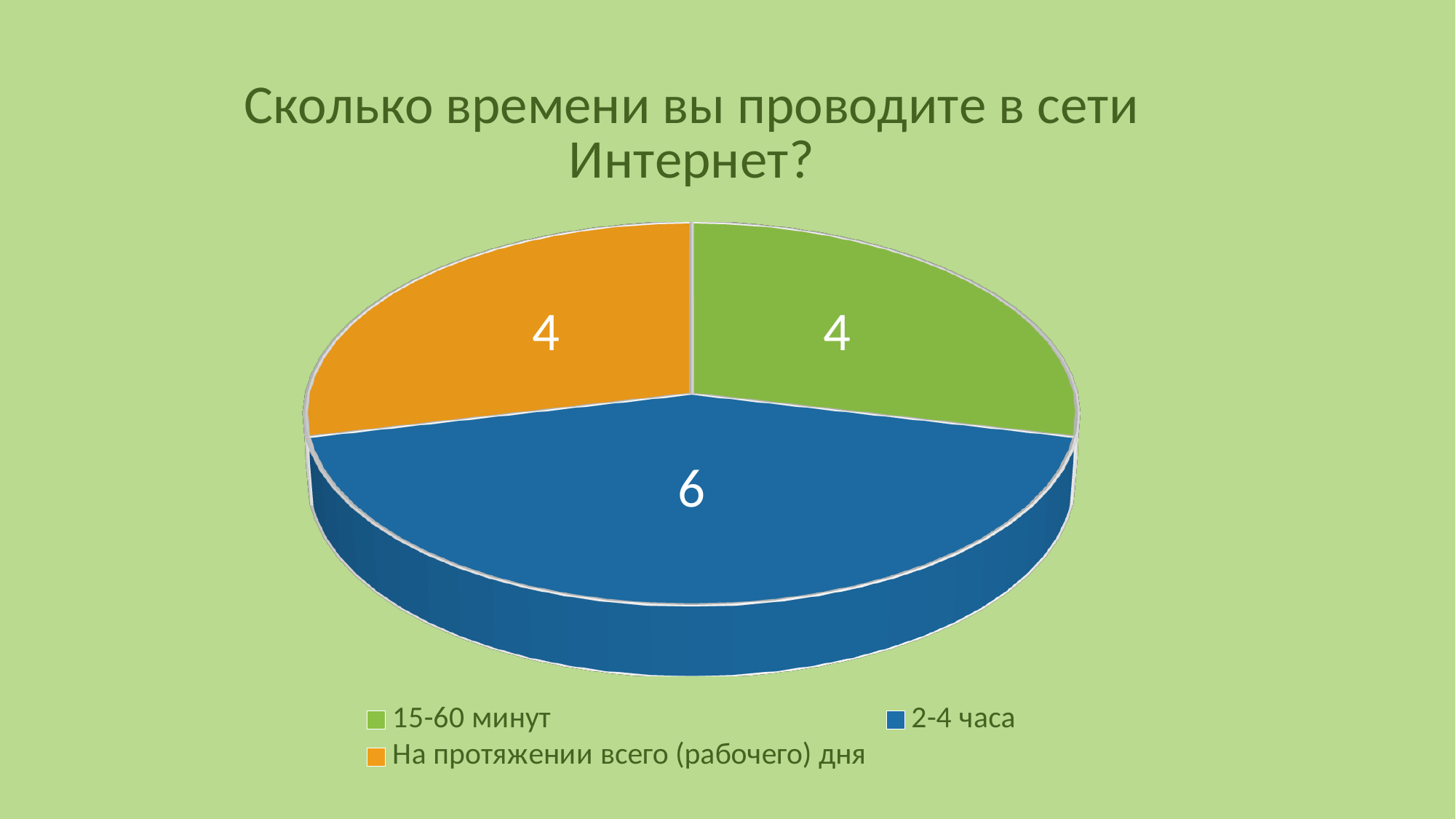
What colour is the "2-4 часа" slice? Blue What is the total of all the values shown on the pie chart? 14 How many slices does the pie chart have? 3 Which is larger: the value for "2-4 часа" or the value for "На протяжении всего (рабочего) дня"? 2-4 часа What value is shown for the "2-4 часа" slice? 6 How many entries does the legend list? 3 What value is shown for the "15-60 минут" slice? 4 What value is shown for the "На протяжении всего (рабочего) дня" slice? 4 What is the difference between the values for "2-4 часа" and "15-60 минут"? 2 What is the title of the chart? Сколько времени вы проводите в сети Интернет? What kind of chart is shown on the slide? Pie chart Which category has the largest slice of the pie? 2-4 часа